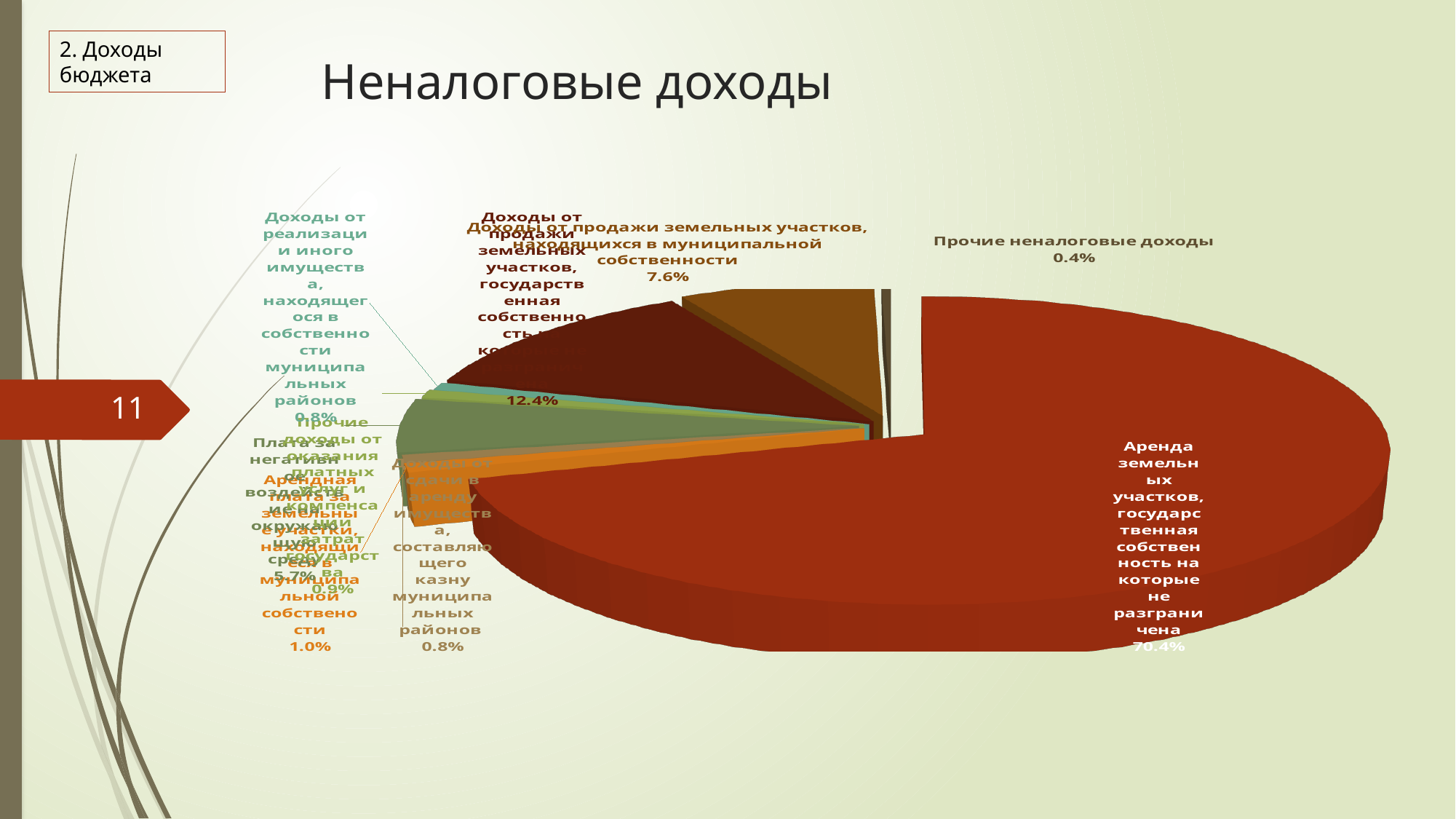
What share of the pie is 'Прочие неналоговые доходы'? 0.4% What is the difference in percentage points between 'Аренда земельных участков, государственная собственность на которые не разграничена' (70.4%) and 'Доходы от продажи земельных участков, находящихся в муниципальной собственности' (7.6%)? 62.8 Which is larger: the share for 'Доходы от продажи земельных участков, находящихся в муниципальной собственности' or the share for 'Плата за негативное воздействие на окружающую среду'? Доходы от продажи земельных участков, находящихся в муниципальной собственности What share of the pie is 'Плата за негативное воздействие на окружающую среду'? 5.7% What is the title of the chart on the slide? Неналоговые доходы Is the share for 'Аренда земельных участков, государственная собственность на которые не разграничена' greater or less than 50%? greater Which category has the largest share of the pie? Аренда земельных участков, государственная собственность на которые не разграничена What is the difference in percentage points between 'Доходы от продажи земельных участков, находящихся в муниципальной собственности' (7.6%) and 'Прочие неналоговые доходы' (0.4%)? 7.2 Which category has the smallest share of the pie? Прочие неналоговые доходы What share of the pie is 'Аренда земельных участков, государственная собственность на которые не разграничена'? 70.4% What kind of chart is shown on the slide? Pie chart What share of the pie is 'Доходы от продажи земельных участков, находящихся в муниципальной собственности'? 7.6%